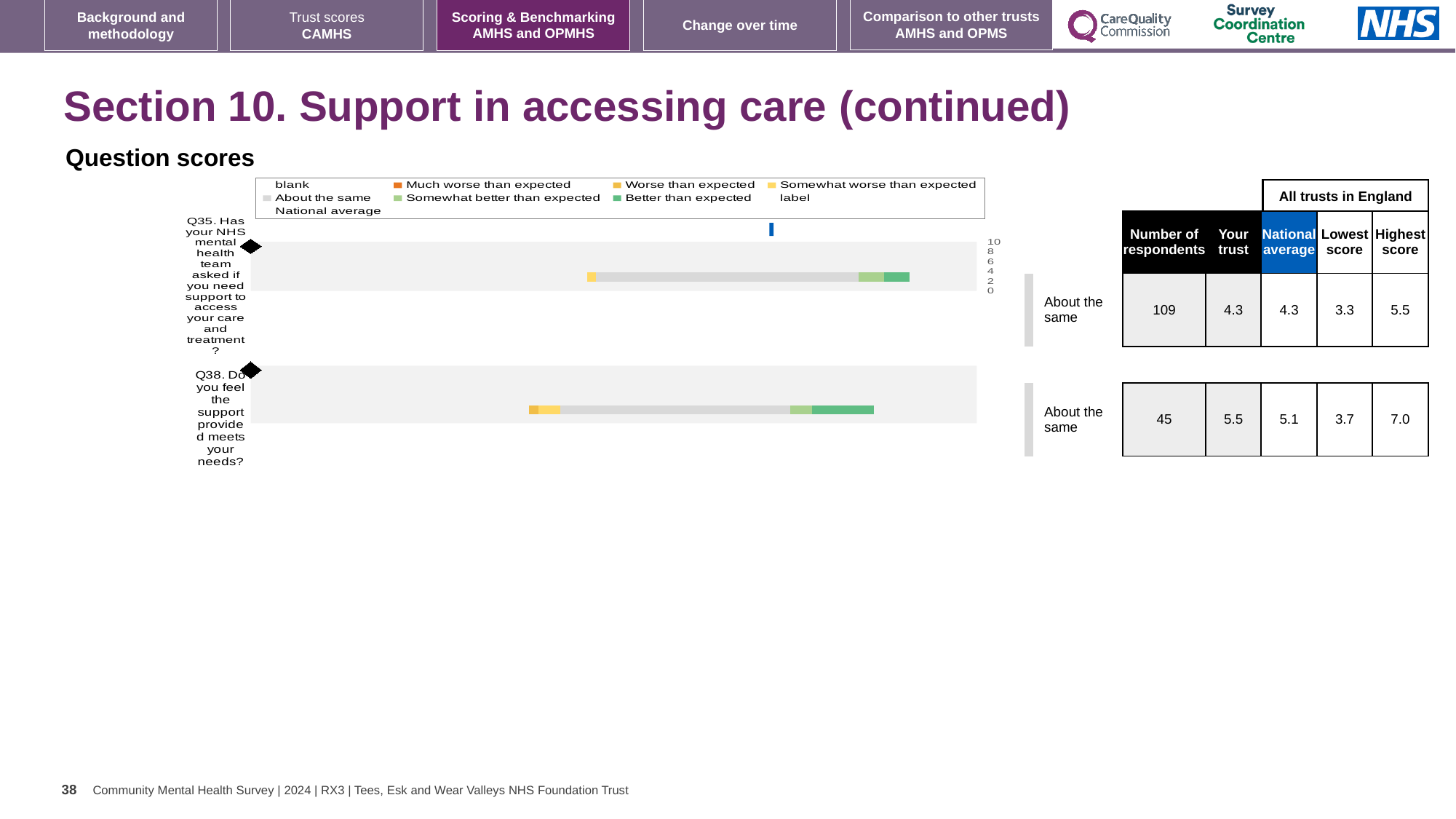
What is the 'Your trust' score for Q38 (Do you feel the support provided meets your needs?)? 5.5 What kind of chart is used to show the question scores on this slide? bar chart In the question scores chart, what does the blue marker represent according to the legend? National average For Q38, which is larger: the 'Your trust' score or the national average? Your trust What benchmark category is shown for Q35? About the same How many questions are plotted in the question scores chart? 2 What is the national average score for Q38? 5.1 Which question has the higher 'Your trust' score, Q35 or Q38? Q38 What is the difference between the highest score and the lowest score for Q38? 3.3 What is the highest score among all trusts in England for Q35? 5.5 How many respondents answered Q35 (Has your NHS mental health team asked if you need support to access your care and treatment?)? 109 What is the lowest score among all trusts in England for Q35? 3.3